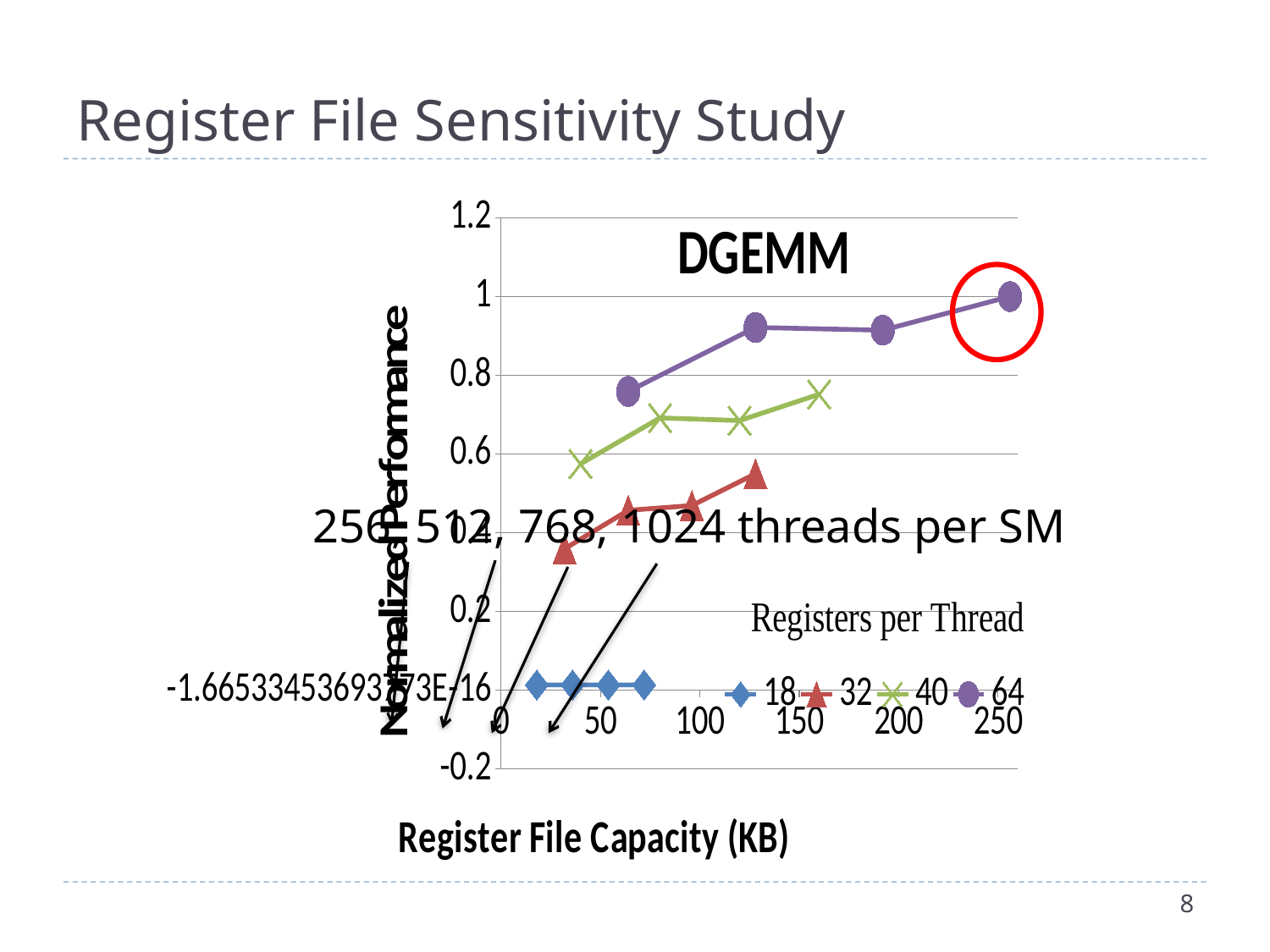
What is the x-axis title of the chart? Register File Capacity (KB) What is the title of the chart? DGEMM Is the highest value of the 32 registers-per-thread series greater or less than 0.6? less Which series (registers per thread) has the lowest normalized performance? 18 At a register file capacity of about 64 KB, which series has the higher normalized performance, 64 or 32 registers per thread? 64 Does the normalized performance of the 64 registers-per-thread series rise or fall as register file capacity increases? rises Is the highest value of the 64 registers-per-thread series greater or less than 0.8? greater How many series does the legend list? 4 What kind of chart is shown on the slide? line chart Which series (registers per thread) reaches the highest normalized performance? 64 How many data points are plotted for the 64 registers-per-thread series? 4 Is the lowest value of the 40 registers-per-thread series greater or less than 0.4? greater